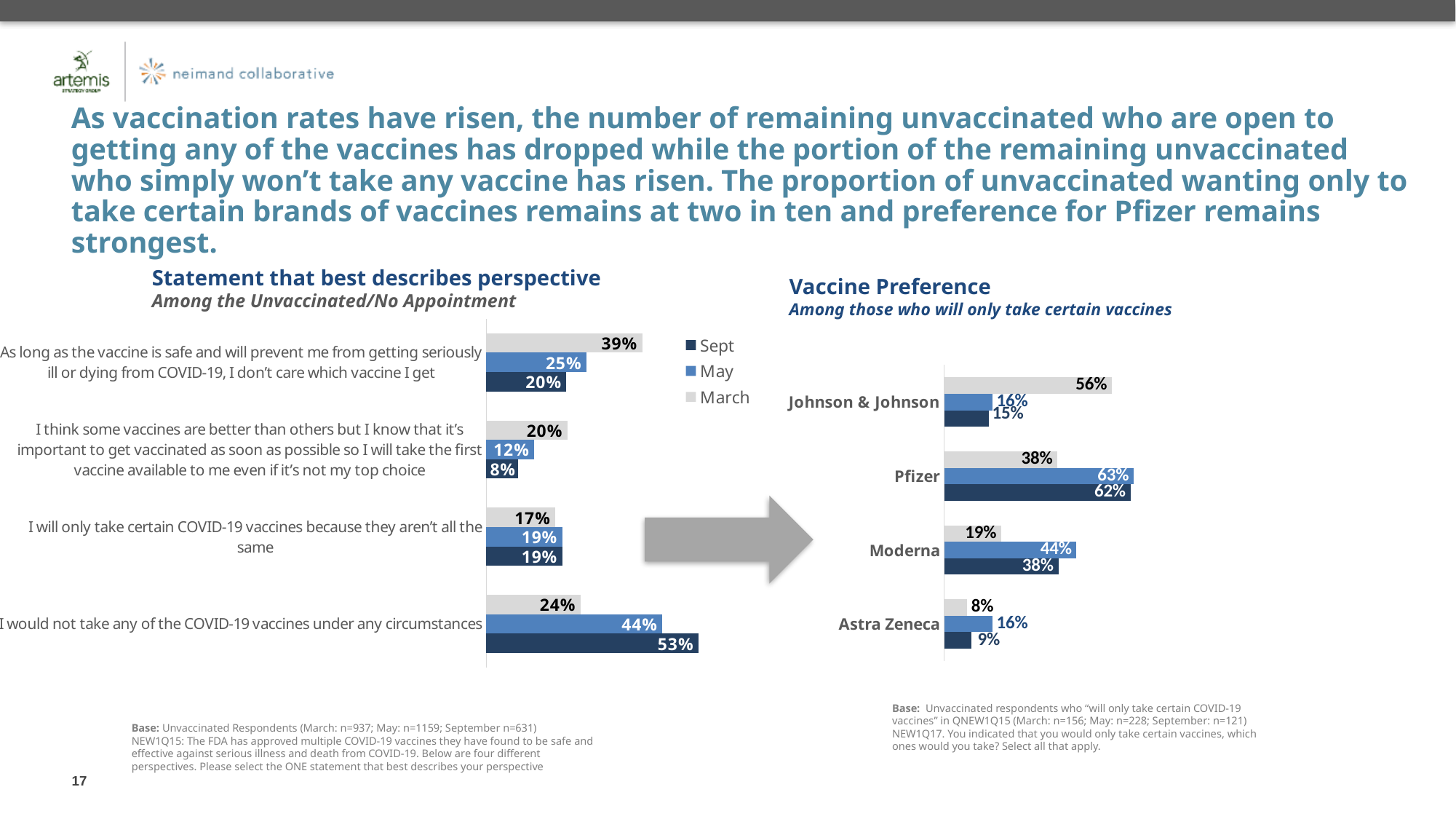
What type of chart is the 'Vaccine Preference' chart? Bar chart In the 'Statement that best describes perspective' chart, what is the Sept value for 'I would not take any of the COVID-19 vaccines under any circumstances'? 53% In the 'Vaccine Preference' chart, what is the March value for Johnson & Johnson? 56% In the 'Statement that best describes perspective' chart, what is the March value for 'As long as the vaccine is safe and will prevent me from getting seriously ill or dying from COVID-19, I don't care which vaccine I get'? 39% How many series does the legend list for the 'Statement that best describes perspective' chart? 3 In the 'Vaccine Preference' chart, is the March value for Johnson & Johnson larger or smaller than the March value for Pfizer? larger In the 'Vaccine Preference' chart, what is the May value for Pfizer? 63% How many vaccines are listed in the 'Vaccine Preference' chart? 4 In the 'Vaccine Preference' chart, which vaccine has the highest Sept value? Pfizer In the 'Vaccine Preference' chart, which vaccine has the lowest March value? Astra Zeneca In the 'Statement that best describes perspective' chart, what is the difference between the Sept and March values for 'I would not take any of the COVID-19 vaccines under any circumstances'? 29% In the 'Vaccine Preference' chart, what is the difference between the May and Sept values for Moderna? 6%